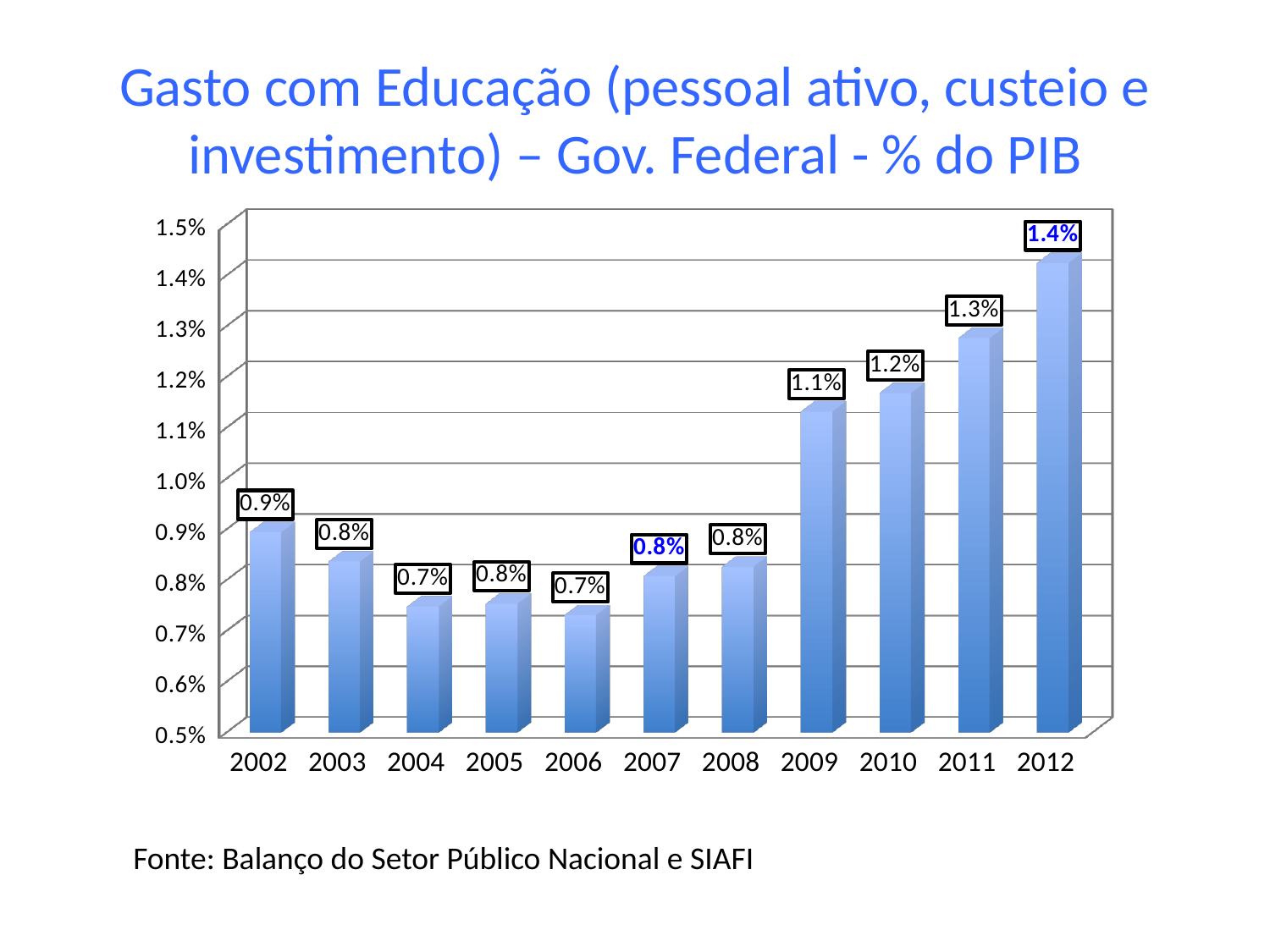
What is the value for 2002? 0.9% What kind of chart is shown on the slide? Bar chart What is the difference between the values for 2011 and 2010? 0.1% Do the values rise or fall from 2008 to 2012? Rise Which year has the highest value? 2012 Is the value for 2010 greater or less than 1.0%? greater How many years are shown on the x axis? 11 What is the difference between the values for 2012 and 2002? 0.5% What is the value for 2012? 1.4% What is the value for 2009? 1.1% What is the value for 2006? 0.7% Which is larger, the value for 2009 or the value for 2008? 2009